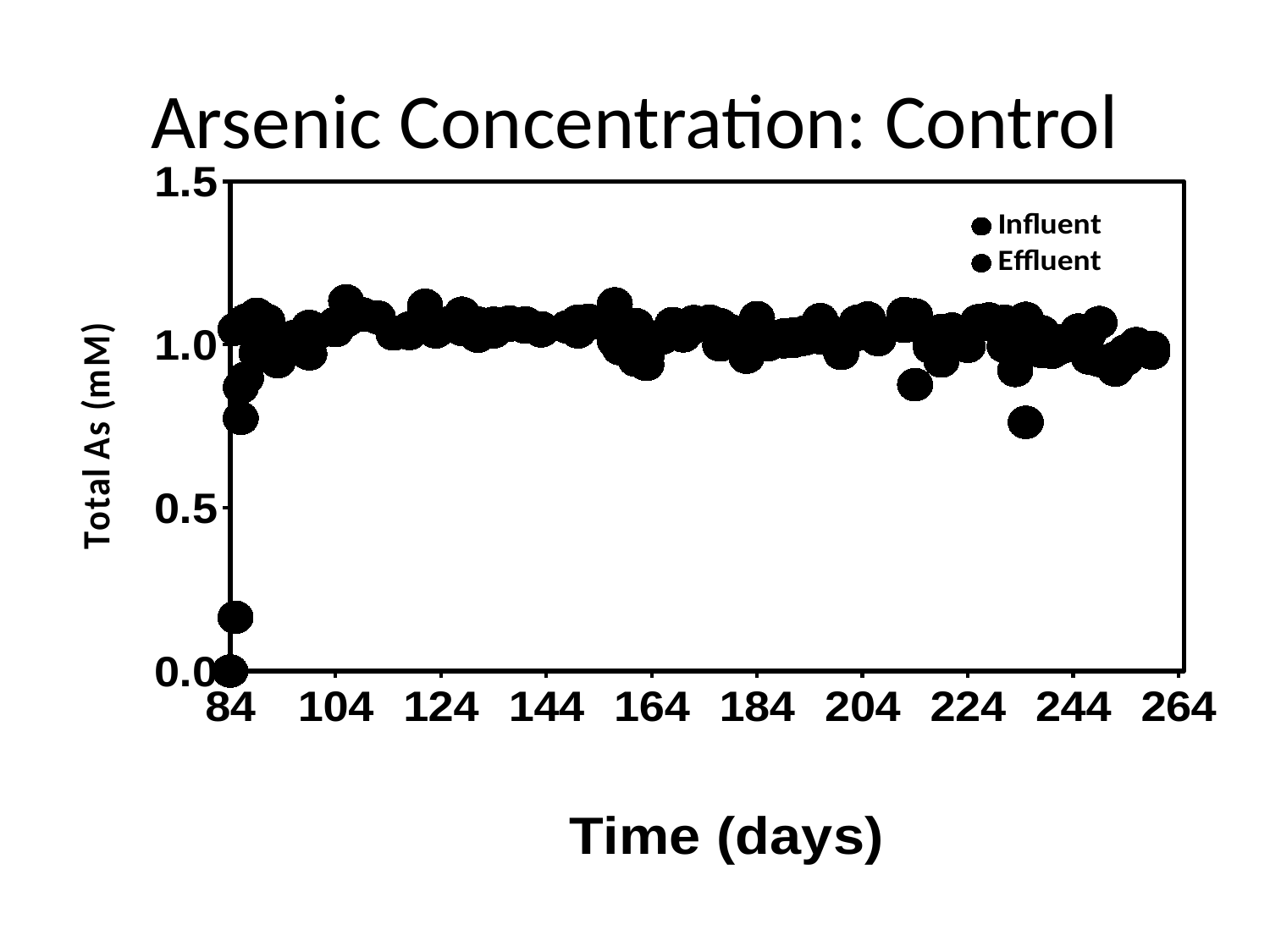
Are the majority of the plotted points greater or less than 0.5 mM? greater Is the highest plotted point on the chart greater or less than 1.5? less What is the title of the chart? Arsenic Concentration: Control What kind of chart is shown on the slide? scatter chart How many series does the legend list? 2 How many tick labels are shown on the x axis? 10 What are the two series named in the legend? Influent and Effluent Is the isolated low point near day 236 greater or less than 1.0? less What is the maximum value shown on the y axis? 1.5